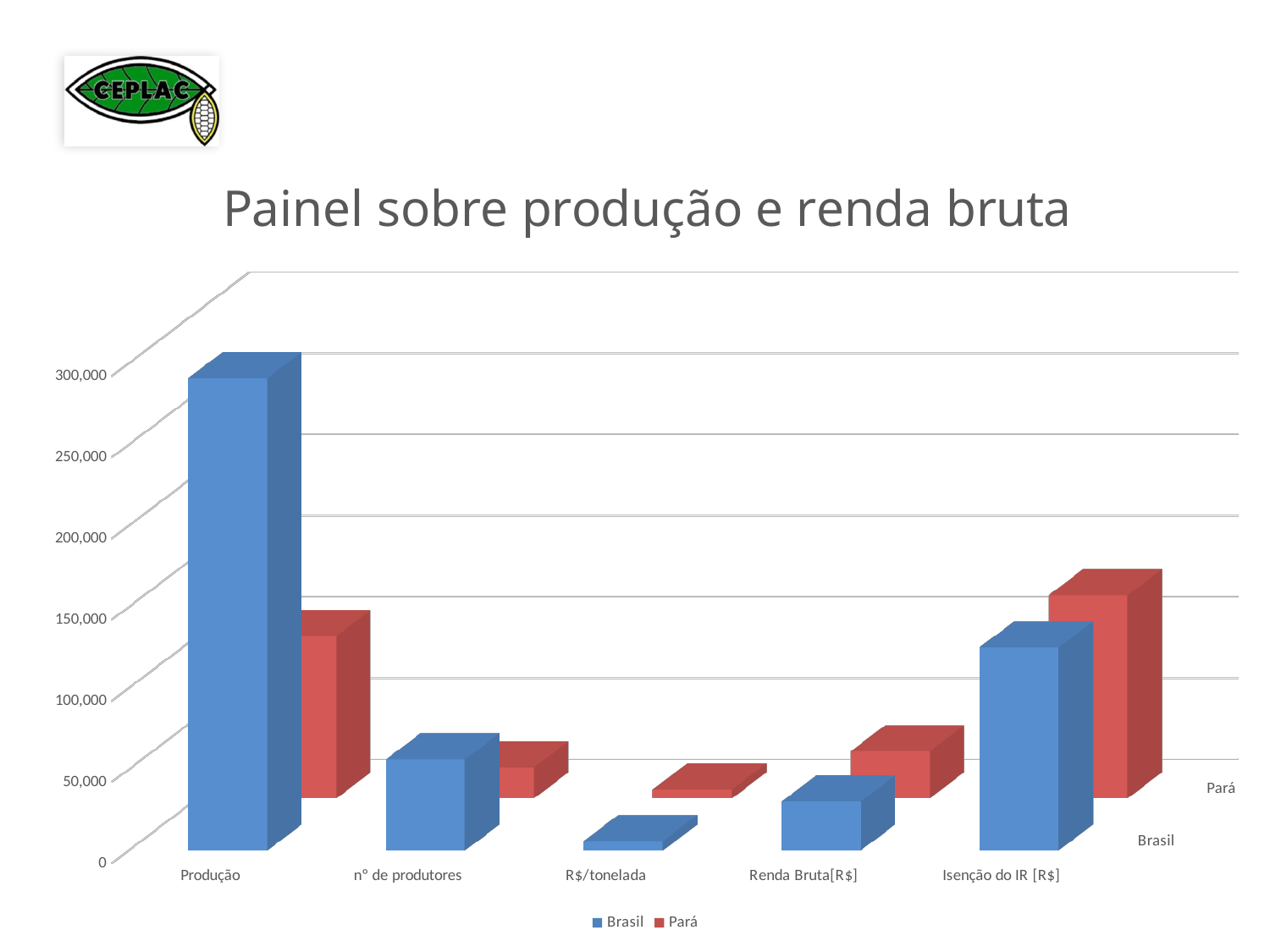
How many series does the legend list? 2 Which category has the lowest value for Brasil? R$/tonelada For Produção, which is larger: Brasil or Pará? Brasil Which series is shown in red? Pará What kind of chart is shown on the slide? bar chart How many categories are shown on the x axis? 5 Is the Brasil value for Produção greater or less than 250,000? greater Which category has the highest value for Brasil? Produção Is the Brasil value for Isenção do IR [R$] greater or less than 100,000? greater Is the Pará value for Produção greater or less than 150,000? less What is the title of the chart? Painel sobre produção e renda bruta